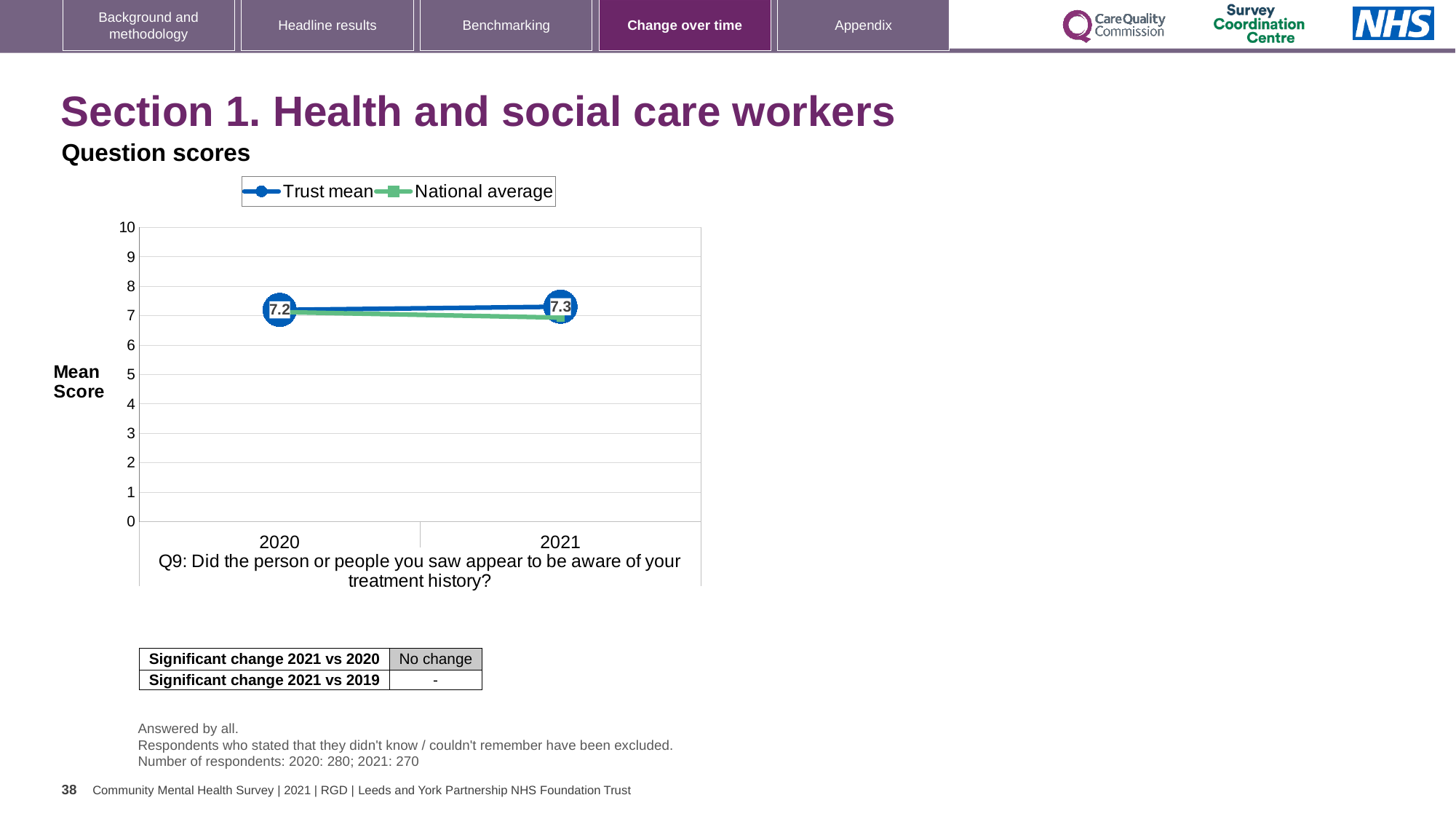
By how much did the Trust mean score change from 2020 to 2021? 0.1 Does the National average rise or fall from 2020 to 2021? fall Is the National average value for 2020 greater or less than 6? greater Is the National average value for 2021 greater or less than 8? less How many years are shown on the x axis? 2 Does the Trust mean rise or fall from 2020 to 2021? rise What kind of chart is shown on the slide? line chart How many series does the legend list? 2 In which year is the Trust mean score higher, 2020 or 2021? 2021 What is the Trust mean score for 2021? 7.3 What is the Trust mean score for 2020? 7.2 In 2021, which is higher, the Trust mean or the National average? Trust mean